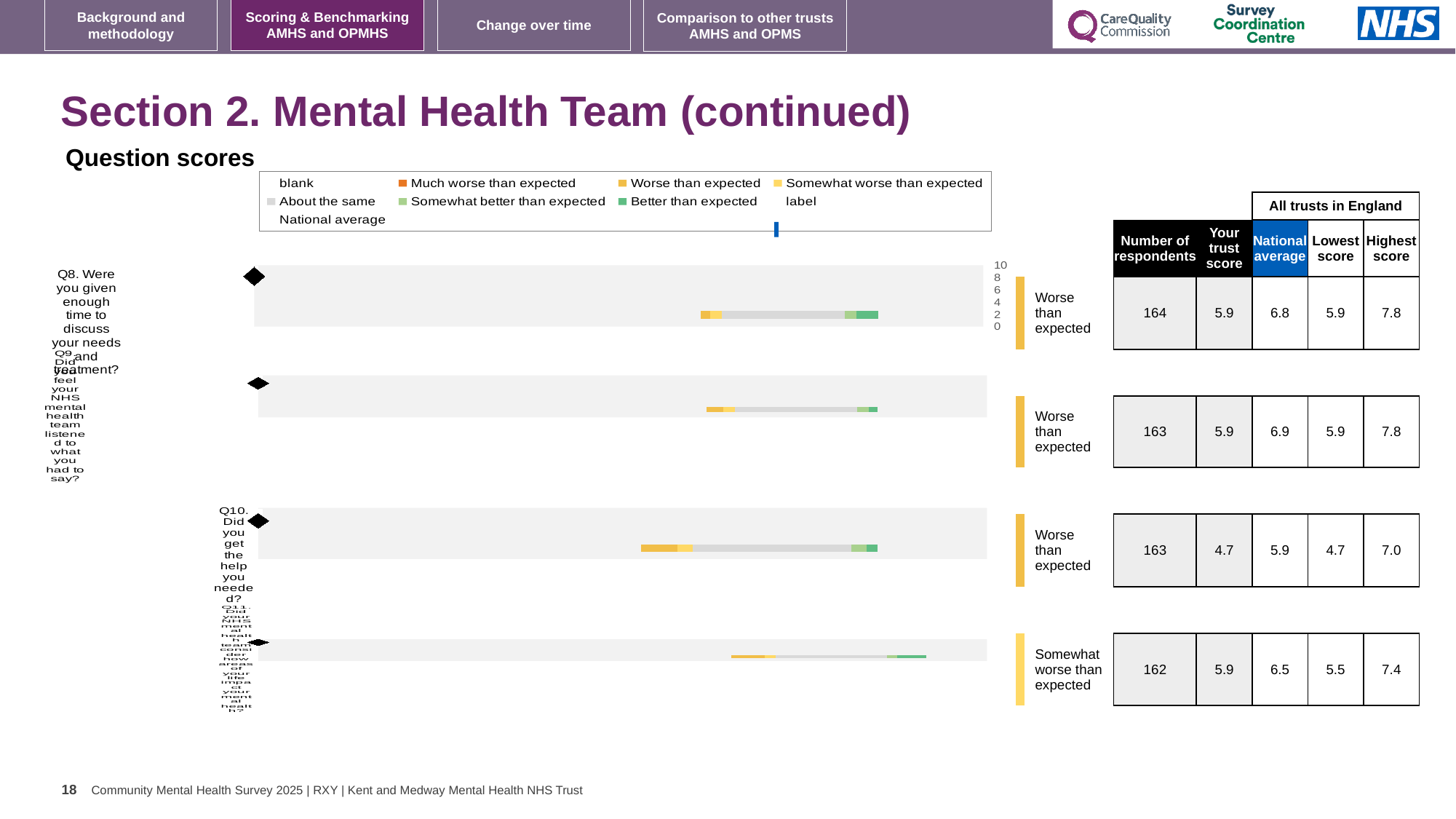
Which question is plotted in the top row of the question scores chart? Q8 In the table beside the question scores chart, what is the national average for Q8? 6.8 What rating label is shown next to the bar for Q10 in the question scores chart? Worse than expected In the table beside the question scores chart, is the highest score for Q9 larger or smaller than the highest score for Q11? larger In the table beside the question scores chart, what is the number of respondents for Q11? 162 In the table beside the question scores chart, what is the difference between the national average and the trust score for Q10? 1.2 How many questions (categories) are plotted in the question scores chart? 4 What is the heading shown above the question scores chart? Question scores In the table beside the question scores chart, what is the trust score for Q10? 4.7 What rating label is shown next to the bar for Q11 in the question scores chart? Somewhat worse than expected In the table beside the question scores chart, which question has the lowest trust score? Q10 What kind of chart is used to show the question scores on this slide? bar chart